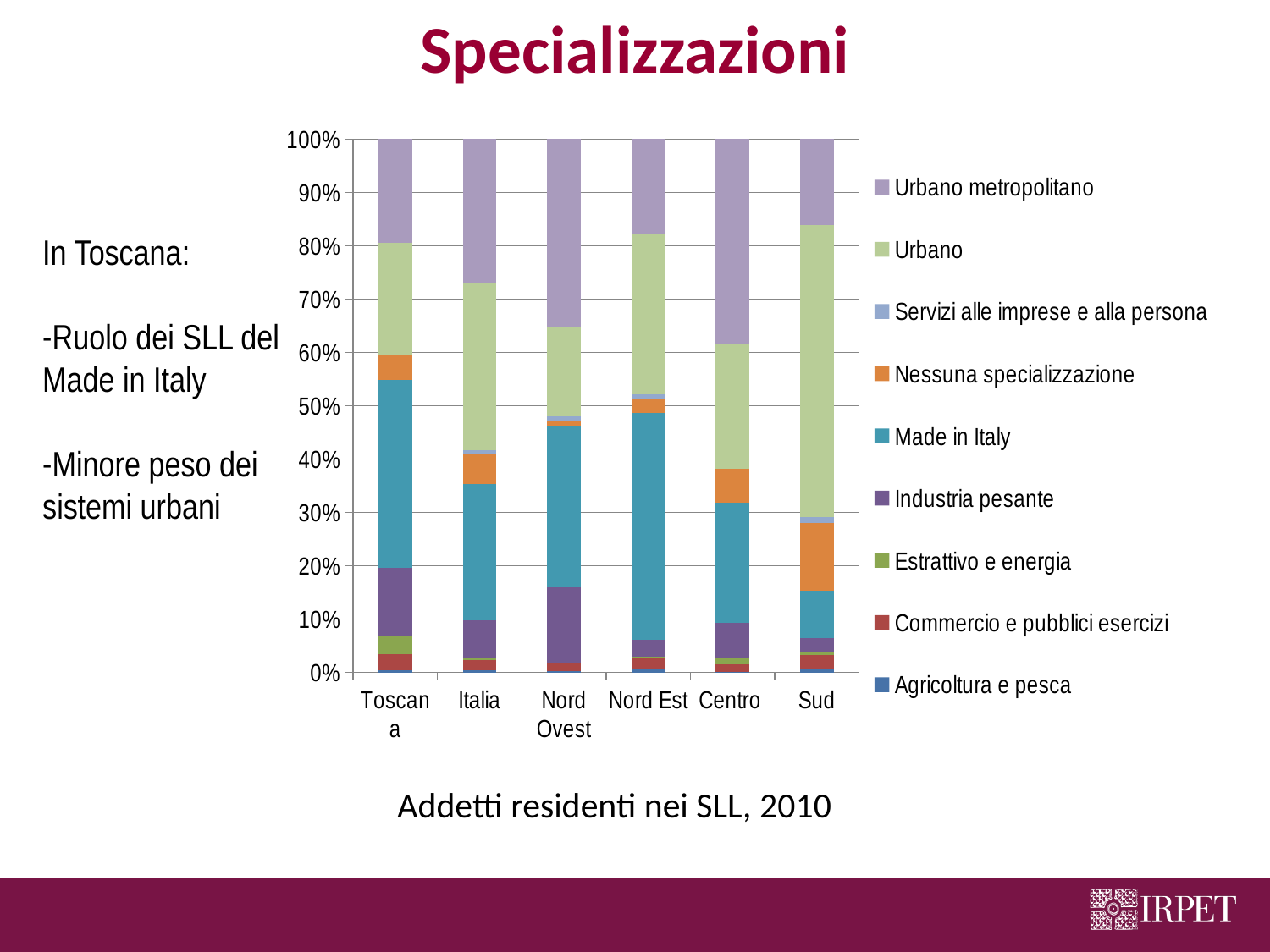
What kind of chart is shown on the slide? Stacked bar chart Is the Made in Italy segment larger for Toscana or for Sud? Toscana How many series does the chart legend list? 9 Which category has the smallest Made in Italy segment? Sud Which category has the largest Urbano segment? Sud How many categories are shown on the x axis of the chart? 6 Which category has the largest Nessuna specializzazione segment? Sud Is the Urbano segment for Sud greater or less than 50%? greater What is the title of the slide containing the chart? Specializzazioni Is the Made in Italy segment for Toscana greater or less than 30%? greater Is the Urbano metropolitano segment larger for Nord Ovest or for Nord Est? Nord Ovest What caption appears below the chart? Addetti residenti nei SLL, 2010